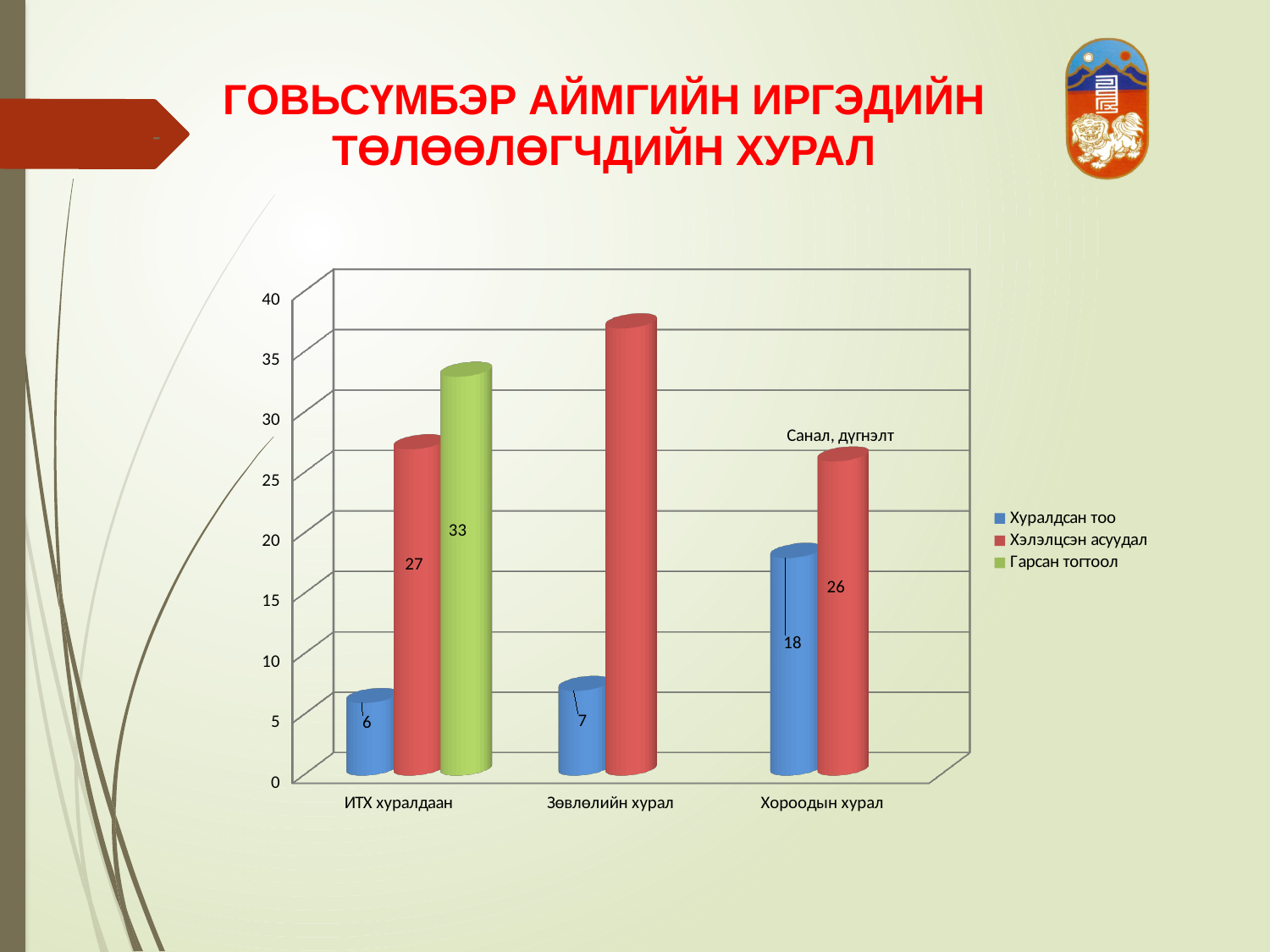
Is the value of Хэлэлцсэн асуудал for Зөвлөлийн хурал greater or less than 35? greater What is the value of Хэлэлцсэн асуудал for Хороодын хурал? 26 What is the value of Хуралдсан тоо for Хороодын хурал? 18 How many series does the legend list? 3 How many categories are shown on the x axis? 3 What is the value of Хуралдсан тоо for ИТХ хуралдаан? 6 What is the difference between Хэлэлцсэн асуудал and Хуралдсан тоо for ИТХ хуралдаан? 21 What kind of chart is shown on the slide? bar chart Which category has the highest value for Хуралдсан тоо? Хороодын хурал What is the value of Хуралдсан тоо for Зөвлөлийн хурал? 7 What is the value of Гарсан тогтоол for ИТХ хуралдаан? 33 What is the value of Хэлэлцсэн асуудал for ИТХ хуралдаан? 27